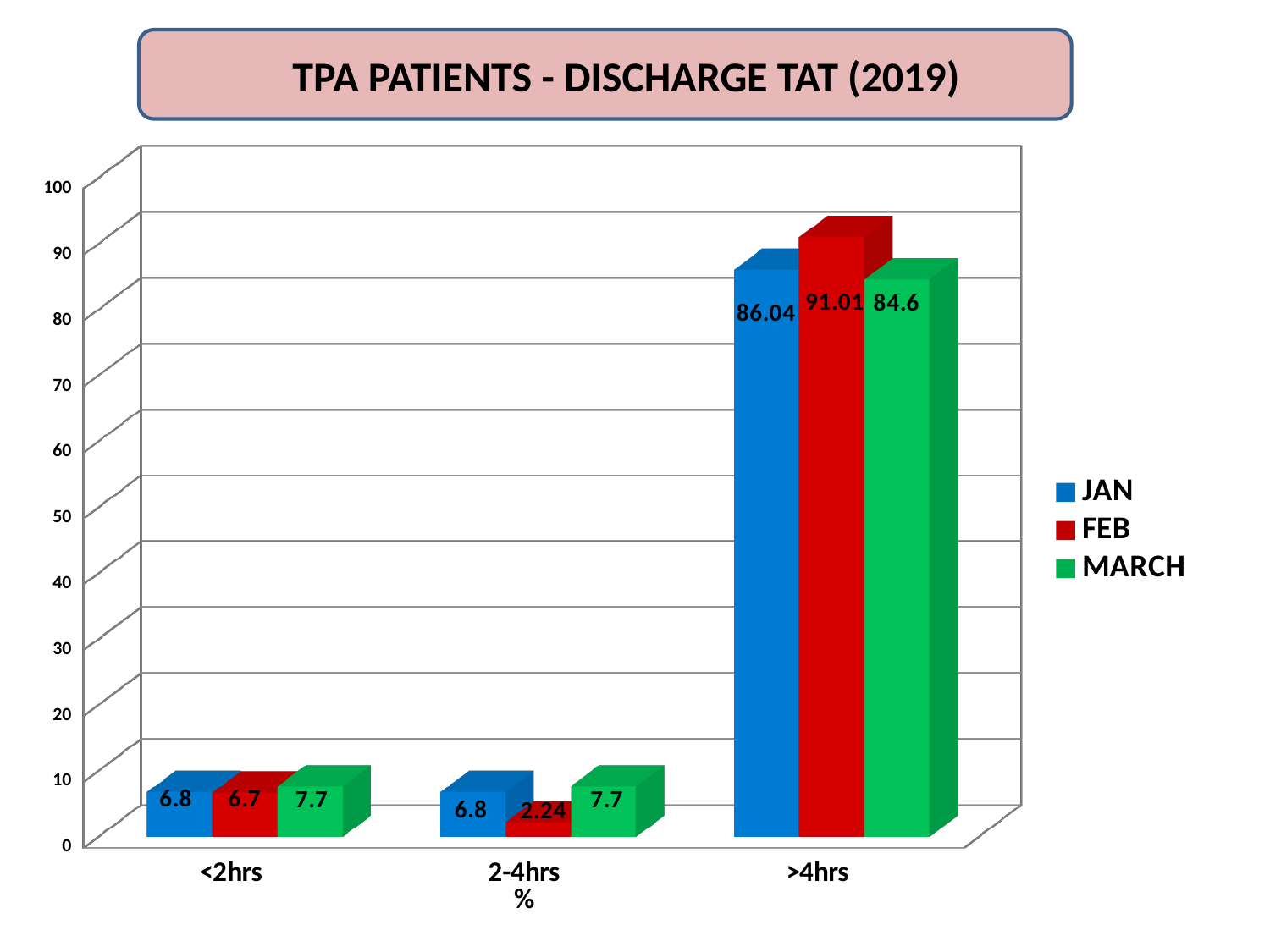
What is the title of the chart? TPA PATIENTS - DISCHARGE TAT (2019) What is the difference between the FEB and MARCH values in the >4hrs category? 6.41 How many categories are shown on the x axis? 3 What kind of chart is shown on the slide? bar chart Which month has the highest value in the >4hrs category? FEB What is the MARCH value for the <2hrs category? 7.7 Which month has the lowest value in the 2-4hrs category? FEB How many series does the legend list? 3 What is the FEB value for the 2-4hrs category? 2.24 Which is larger: the JAN value for 2-4hrs or the FEB value for 2-4hrs? JAN What is the JAN value for the >4hrs category? 86.04 Is the MARCH value for >4hrs greater or less than 80? greater